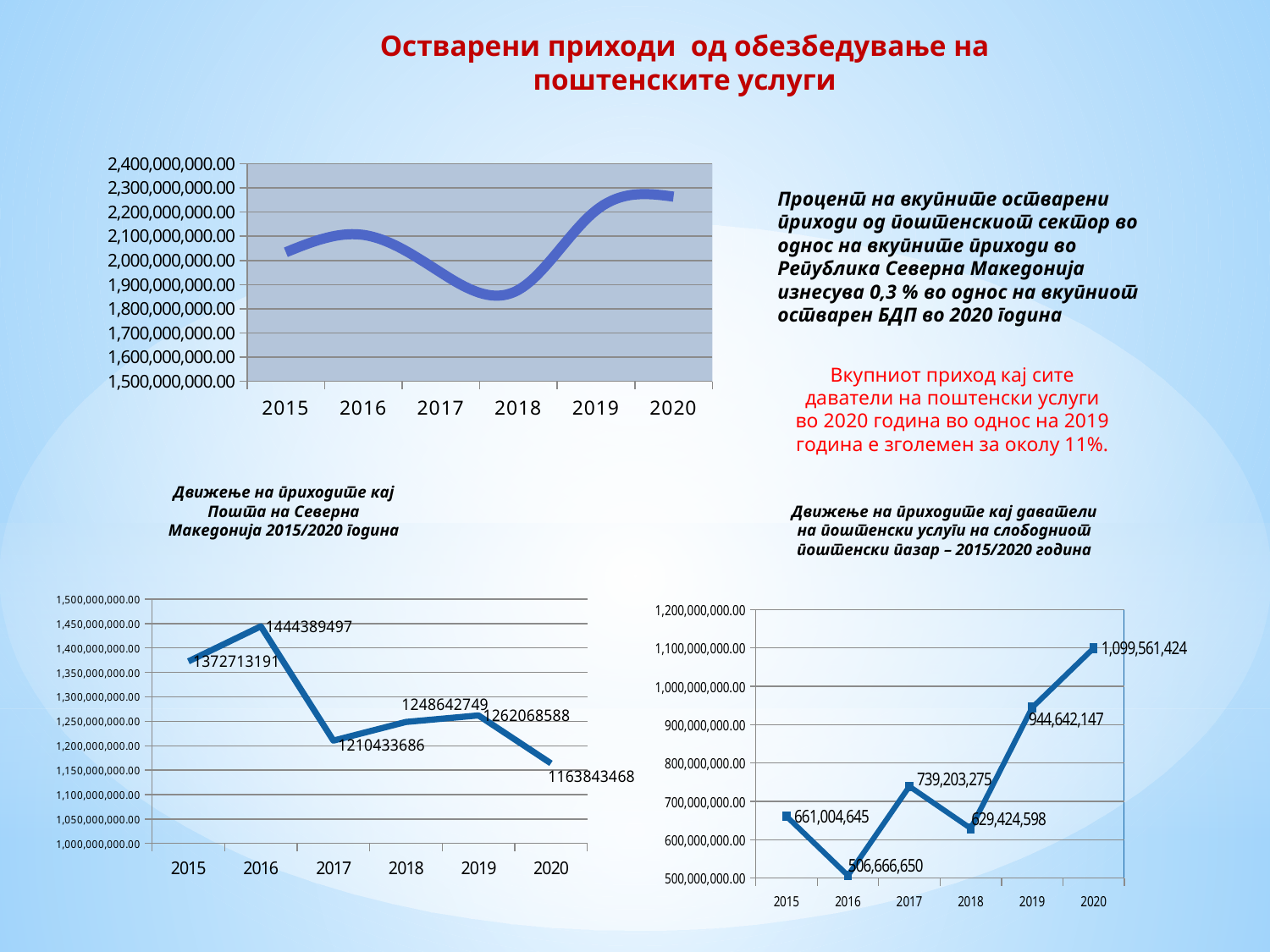
In the bottom-right chart (даватели на поштенски услуги на слободниот пазар), what is the difference between the 2020 and 2019 values? 154,919,277 In the bottom-left chart (Пошта на Северна Македонија), which year has the lowest value? 2020 In the bottom-left chart (Пошта на Северна Македонија), what is the value for 2020? 1163843468 In the bottom-right chart (даватели на поштенски услуги на слободниот пазар), which year has the lowest value? 2016 In the top-left chart, is the value for 2020 greater or less than 2,200,000,000.00? greater In the top-left chart, is the value for 2018 greater or less than 1,900,000,000.00? less In the bottom-right chart (даватели на поштенски услуги на слободниот пазар), which is larger, the value for 2017 or the value for 2018? 2017 In the bottom-left chart (Пошта на Северна Македонија), what is the difference between the 2016 and 2015 values? 71676306 In the bottom-left chart (Пошта на Северна Македонија), which year has the highest value? 2016 In the bottom-left chart (Движење на приходите кај Пошта на Северна Македонија), what is the value for 2016? 1444389497 How many years are plotted on the x axis of the top-left chart? 6 In the bottom-right chart (даватели на поштенски услуги на слободниот пазар), what is the value for 2019? 944,642,147